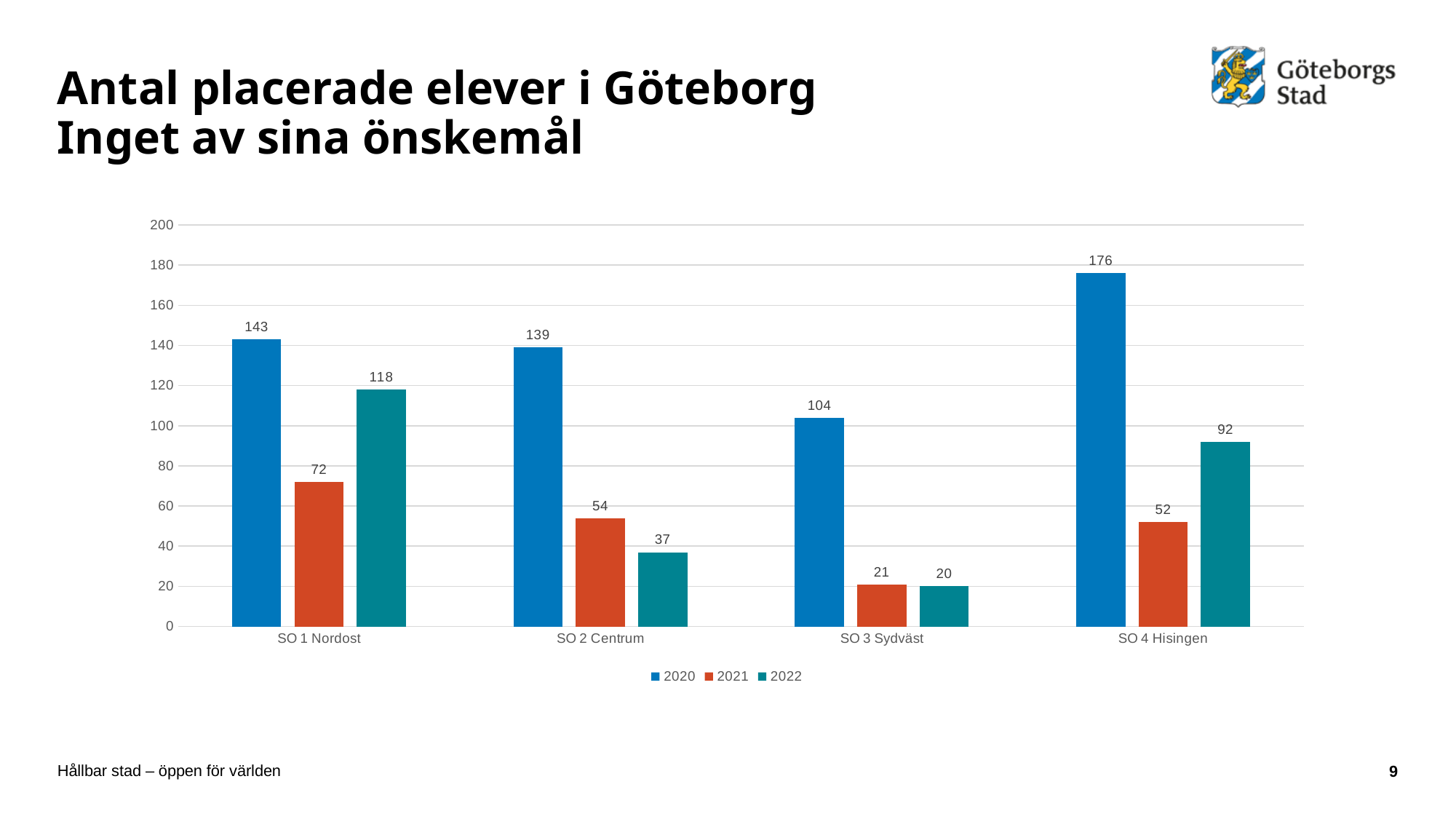
What is the value for SO 4 Hisingen in 2021? 52 What kind of chart is shown on the slide? Bar chart Which years are listed in the legend? 2020, 2021, 2022 What is the value for SO 1 Nordost in 2020? 143 How many series does the legend list? 3 Which category has the lowest value in the 2021 series? SO 3 Sydväst Do the values for SO 3 Sydväst rise or fall from 2020 to 2022? Fall How many categories are shown on the x axis? 4 What is the difference between the 2020 and 2022 values for SO 2 Centrum? 102 Which category has the highest value in the 2020 series? SO 4 Hisingen What is the value for SO 3 Sydväst in 2022? 20 Which is larger: the 2022 value for SO 1 Nordost or the 2022 value for SO 4 Hisingen? SO 1 Nordost